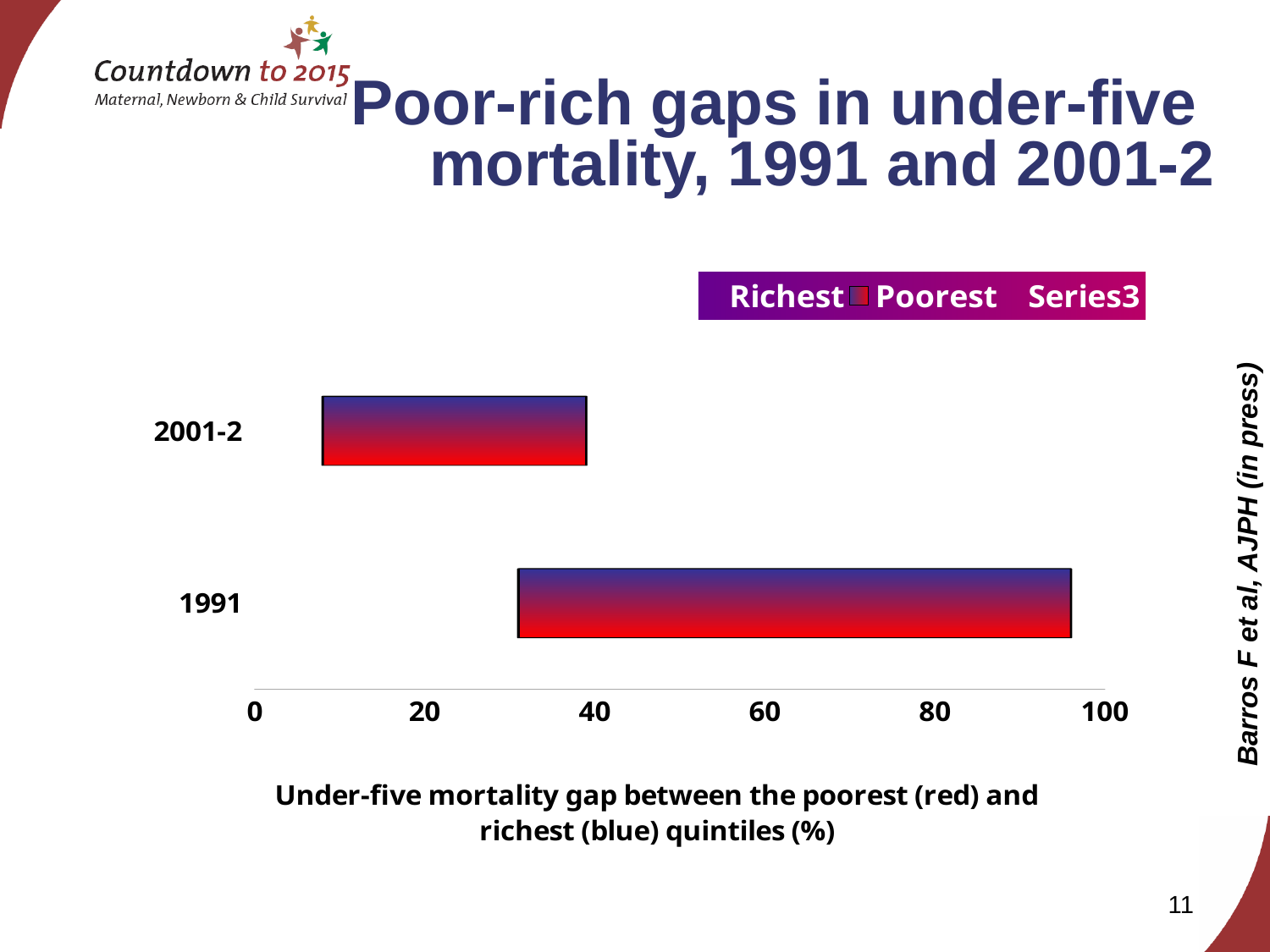
Is the right end of the 1991 bar greater or less than 80? greater Which category's bar extends furthest to the right on the chart? 1991 Which category's bar reaches the lowest value on the x axis? 2001-2 How many categories (time periods) are plotted on the y axis of the chart? 2 Is the right end of the 2001-2 bar greater or less than 60? less What is the title of the chart on the slide? Poor-rich gaps in under-five mortality, 1991 and 2001-2 Is the left end of the 2001-2 bar greater or less than 20? less What is the label of the x axis of the chart? Under-five mortality gap between the poorest (red) and richest (blue) quintiles (%) How many series does the chart legend list? 3 What kind of chart is shown on the slide? bar chart Which bar is longer, the one for 1991 or the one for 2001-2? 1991